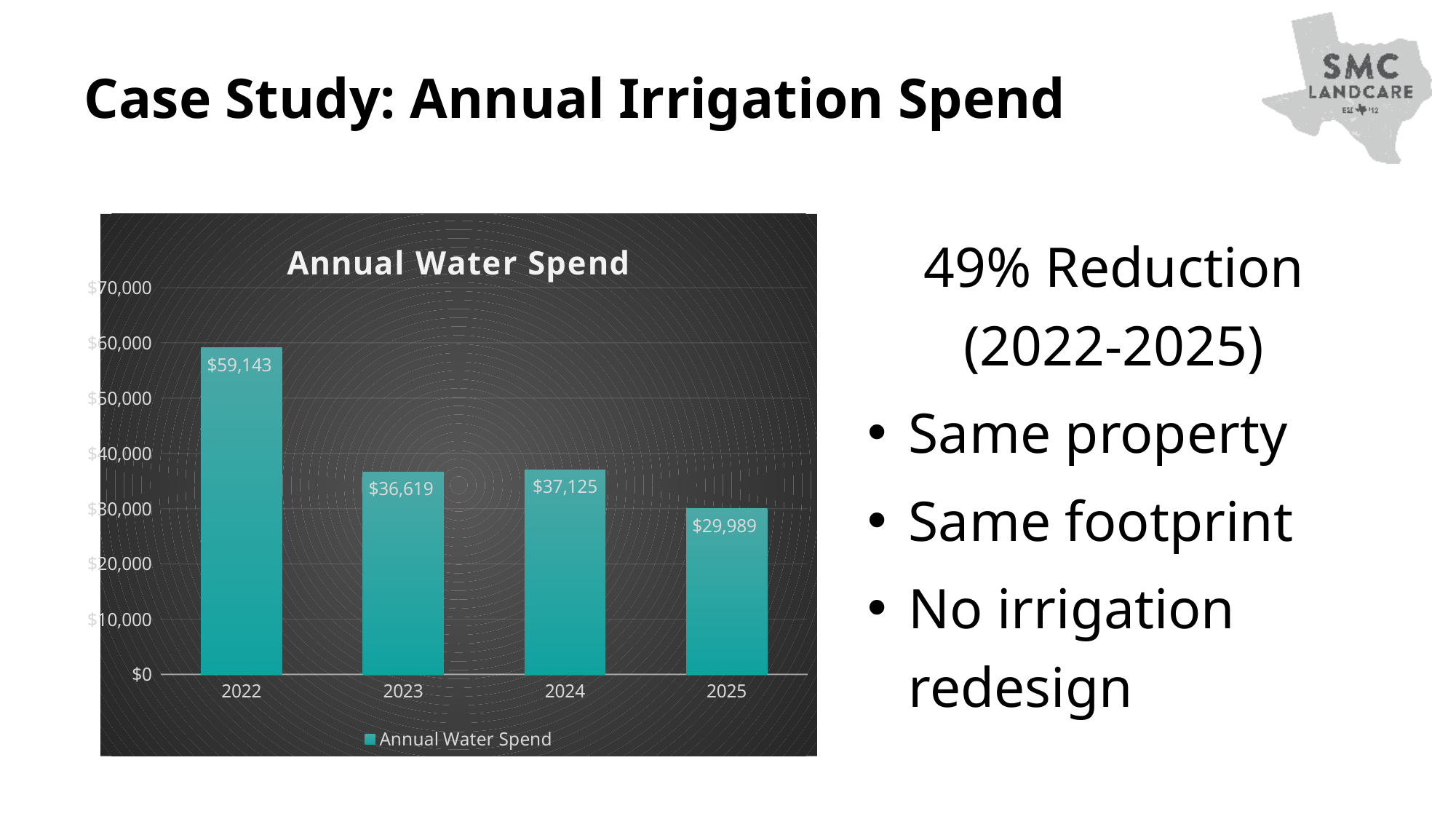
What is the difference between the Annual Water Spend in 2022 and in 2025? $29,154 What kind of chart is shown on the slide? bar chart What is the Annual Water Spend for 2023? $36,619 Is the Annual Water Spend for 2022 greater or less than $50,000? greater What is the difference between the Annual Water Spend in 2024 and in 2023? $506 How many years are shown on the x axis of the chart? 4 Overall, does the Annual Water Spend rise or fall from 2022 to 2025? fall Which year has the highest Annual Water Spend? 2022 What is the Annual Water Spend for 2022? $59,143 Which year has the lowest Annual Water Spend? 2025 What is the Annual Water Spend for 2025? $29,989 Which year has the larger Annual Water Spend, 2023 or 2024? 2024